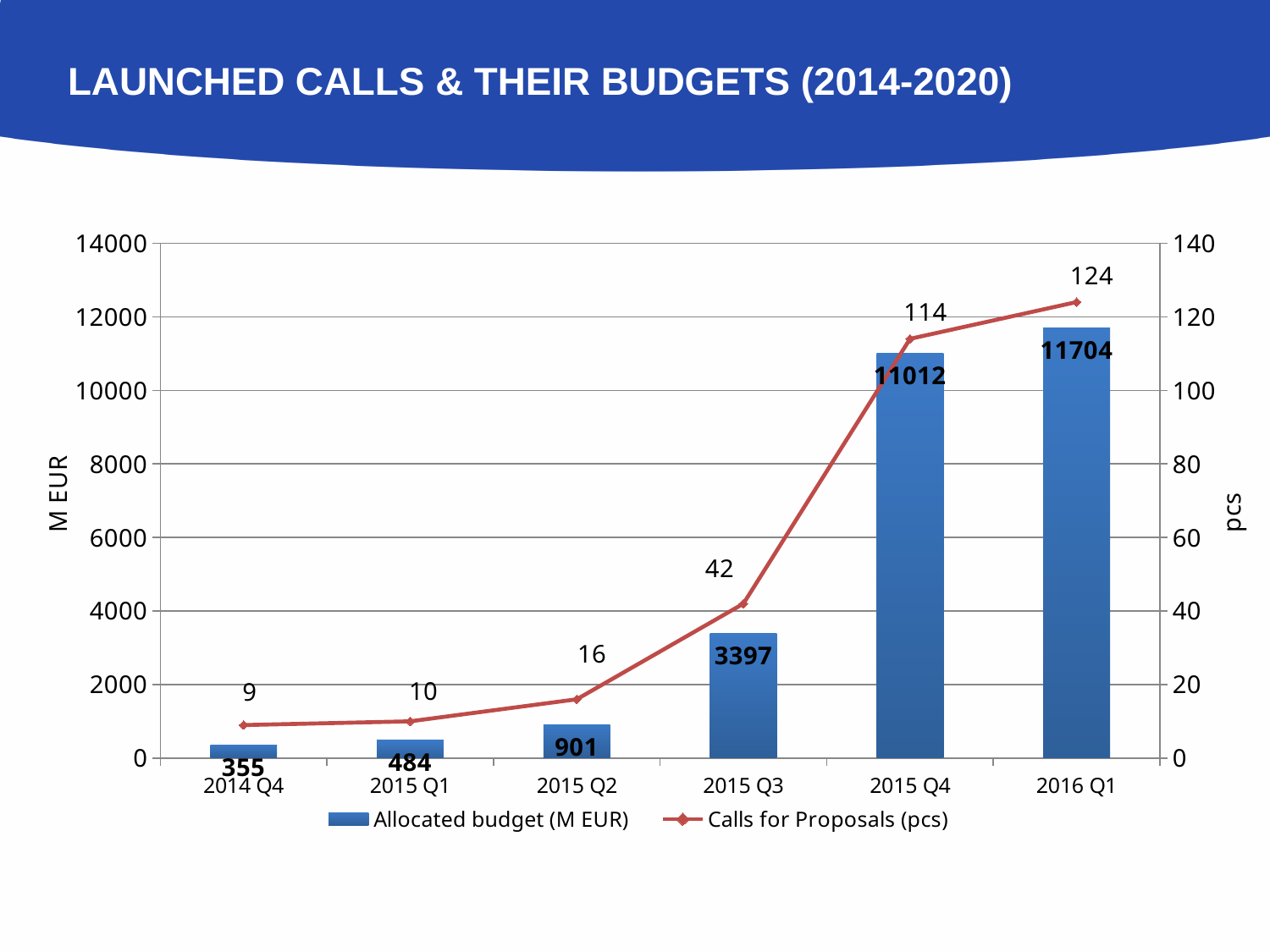
Do the calls for proposals rise or fall from 2014 Q4 to 2016 Q1? rise What is the allocated budget (M EUR) for 2015 Q3? 3397 Which quarter has the highest allocated budget? 2016 Q1 What is the difference in allocated budget (M EUR) between 2016 Q1 and 2015 Q4? 692 How many quarters are shown on the x axis? 6 What is the difference in calls for proposals between 2015 Q3 and 2015 Q2? 26 What is the label of the right-hand vertical axis? pcs How many series does the legend list? 2 How many calls for proposals (pcs) were there in 2015 Q4? 114 What is the allocated budget (M EUR) for 2014 Q4? 355 Which is larger, the allocated budget for 2015 Q1 or for 2015 Q2? 2015 Q2 Which quarter has the lowest number of calls for proposals? 2014 Q4